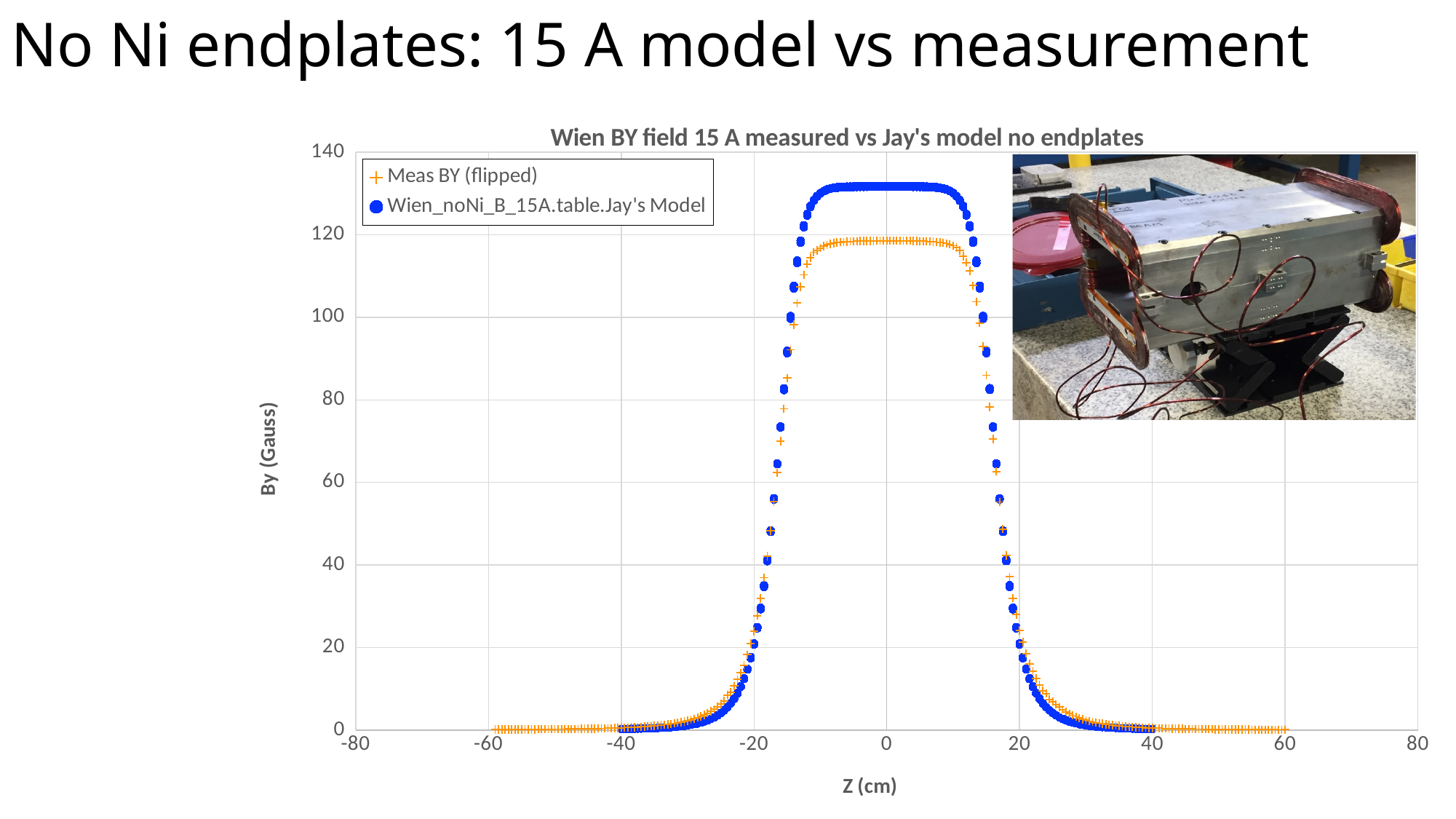
Is the peak value of the Wien_noNi_B_15A.table.Jay's Model series greater or less than 120? greater What is the label of the vertical axis of the chart? By (Gauss) What kind of chart is shown on the slide? scatter chart Between Z = -20 cm and Z = 0 cm, do the values of the Meas BY (flipped) series rise or fall? rise At Z = -20 cm, is the value of the Wien_noNi_B_15A.table.Jay's Model series greater or less than 40? less How many series does the chart's legend list? 2 Between Z = 0 cm and Z = 20 cm, do the values of the Wien_noNi_B_15A.table.Jay's Model series rise or fall? fall Is the peak value of the Meas BY (flipped) series greater or less than 100? greater What is the title of the chart? Wien BY field 15 A measured vs Jay's model no endplates Which series reaches a higher maximum value, Meas BY (flipped) or Wien_noNi_B_15A.table.Jay's Model? Wien_noNi_B_15A.table.Jay's Model